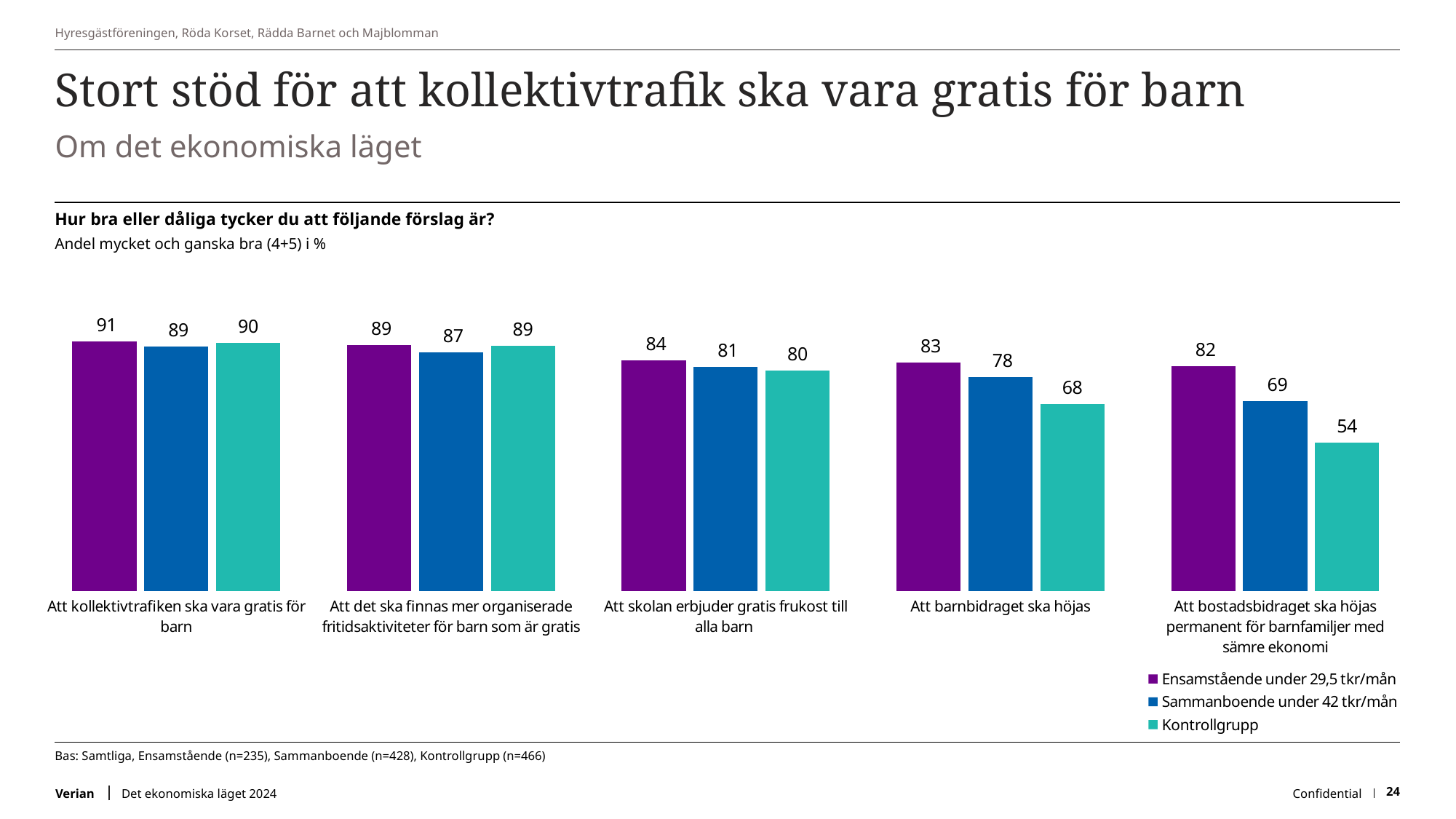
What is the difference between the Ensamstående under 29,5 tkr/mån value and the Kontrollgrupp value for 'Att bostadsbidraget ska höjas permanent för barnfamiljer med sämre ekonomi'? 28 What is the value for Ensamstående under 29,5 tkr/mån for 'Att skolan erbjuder gratis frukost till alla barn'? 84 Which proposal has the highest value for Ensamstående under 29,5 tkr/mån? Att kollektivtrafiken ska vara gratis för barn Which colour represents Kontrollgrupp in the chart? Teal What is the value for Kontrollgrupp for 'Att bostadsbidraget ska höjas permanent för barnfamiljer med sämre ekonomi'? 54 Which proposal has the lowest value for Kontrollgrupp? Att bostadsbidraget ska höjas permanent för barnfamiljer med sämre ekonomi How many series does the legend list? 3 How many proposals (categories) are shown in the chart? 5 What is the value for Sammanboende under 42 tkr/mån for 'Att barnbidraget ska höjas'? 78 What is the difference between the Ensamstående under 29,5 tkr/mån value and the Kontrollgrupp value for 'Att barnbidraget ska höjas'? 15 For 'Att barnbidraget ska höjas', which is larger: the value for Sammanboende under 42 tkr/mån or the value for Kontrollgrupp? Sammanboende under 42 tkr/mån What kind of chart is shown on the slide? Bar chart